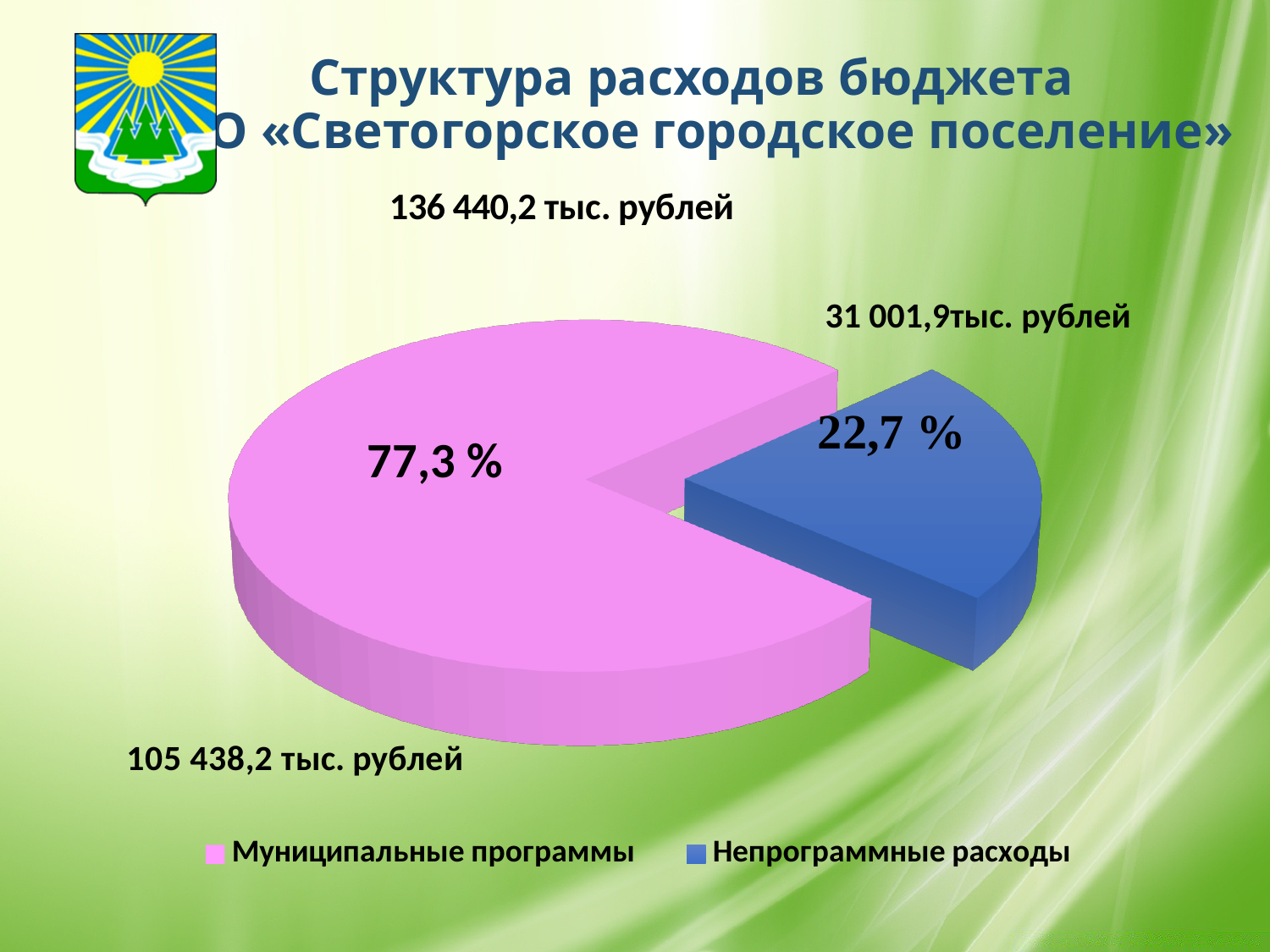
How many slices does the pie chart have? 2 What share of the pie does Муниципальные программы take? 77,3 % Which is larger, Муниципальные программы or Непрограммные расходы? Муниципальные программы What is the value shown for Непрограммные расходы in тыс. рублей? 31 001,9 тыс. рублей What colour is the Непрограммные расходы slice? Blue What kind of chart is shown on the slide? Pie chart Which slice is the smallest in the pie chart? Непрограммные расходы Which slice is the largest in the pie chart? Муниципальные программы What is the total of the two slices shown on the slide? 136 440,2 тыс. рублей What is the value shown for Муниципальные программы in тыс. рублей? 105 438,2 тыс. рублей How many entries does the legend list? 2 What share of the pie does Непрограммные расходы take? 22,7 %